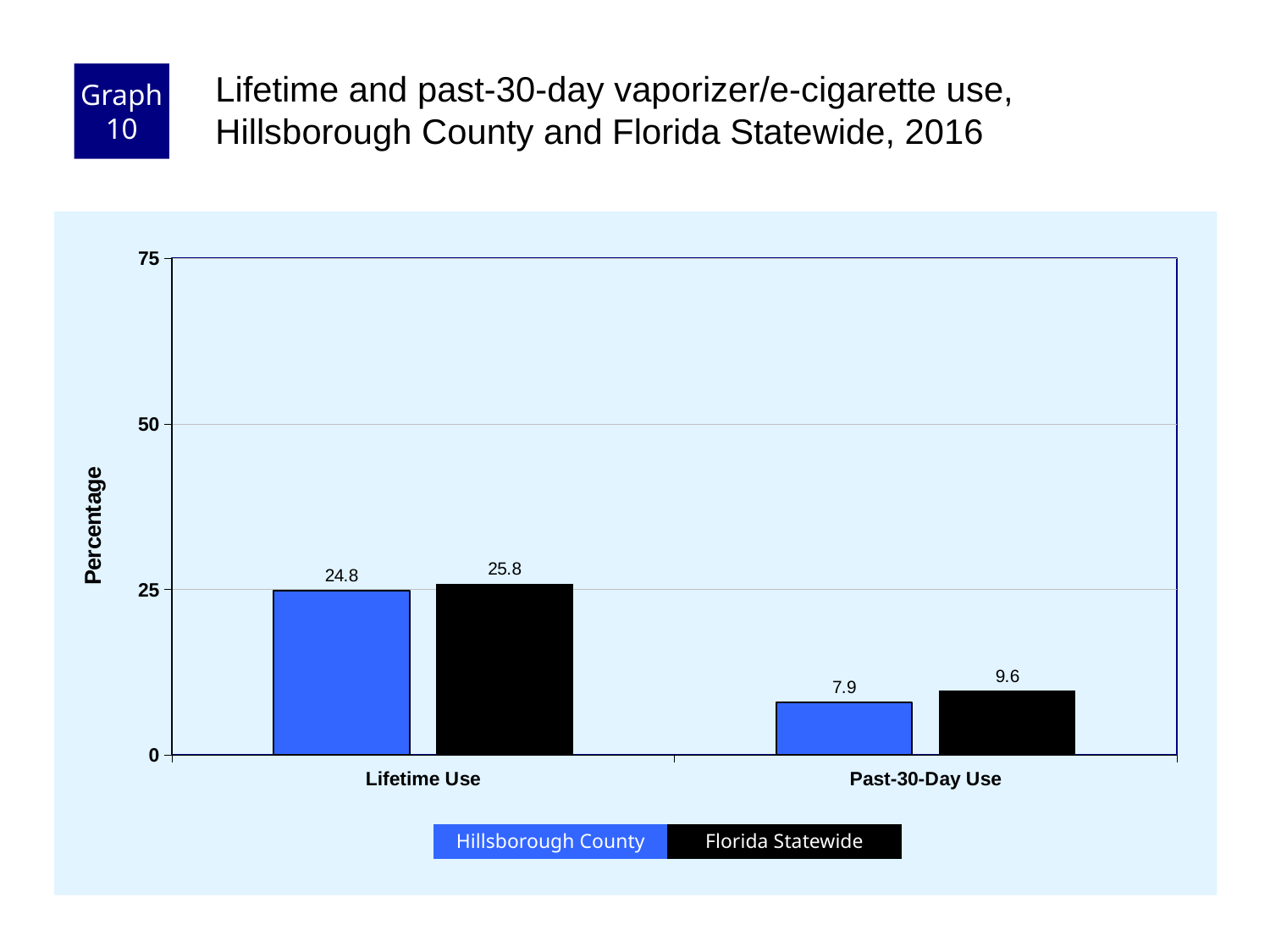
What is the label of the y axis? Percentage How many series does the legend list? 2 What is the value for Hillsborough County for Past-30-Day Use? 7.9 Which bar has the highest value on the chart? Florida Statewide, Lifetime Use Which is larger for Lifetime Use: Hillsborough County or Florida Statewide? Florida Statewide What is the difference between Florida Statewide and Hillsborough County for Past-30-Day Use? 1.7 What is the difference between Florida Statewide and Hillsborough County for Lifetime Use? 1.0 What is the value for Florida Statewide for Lifetime Use? 25.8 What is the value for Hillsborough County for Lifetime Use? 24.8 What is the value for Florida Statewide for Past-30-Day Use? 9.6 Which bar has the lowest value on the chart? Hillsborough County, Past-30-Day Use What kind of chart is shown on the slide? Bar chart